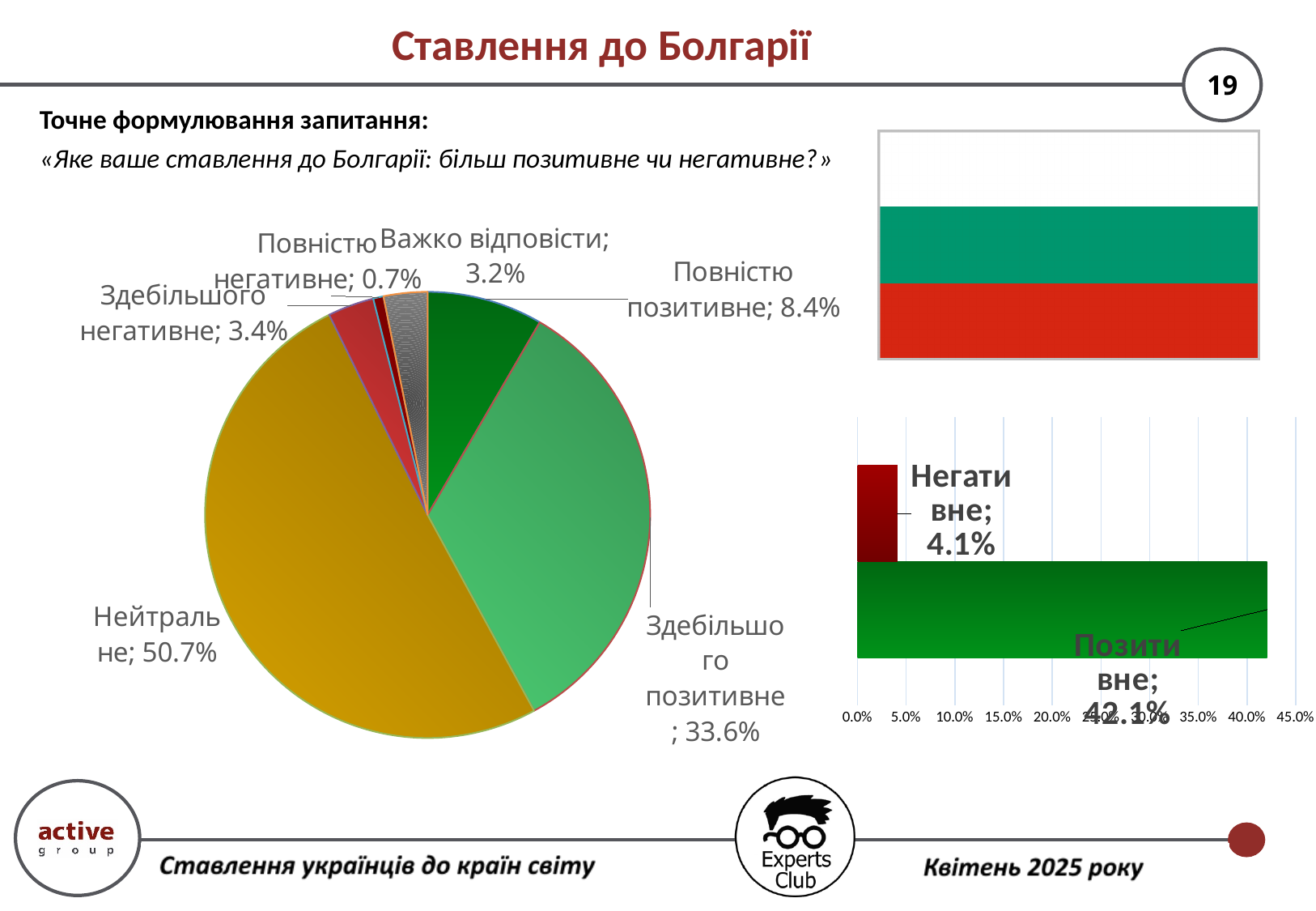
In the pie chart, how many slices (categories) are there? 6 In the bar chart on the right, what is the difference between «Позитивне» and «Негативне»? 38.0% In the pie chart, which category has the smallest share? Повністю негативне In the pie chart, what share is labelled for «Повністю позитивне»? 8.4% In the pie chart, what share is labelled for «Здебільшого позитивне»? 33.6% In the bar chart on the right, what is the value for «Позитивне»? 42.1% What type of chart is shown on the right side of the slide below the flag? Bar chart In the pie chart, which category has the largest share? Нейтральне In the bar chart on the right, what is the value for «Негативне»? 4.1% In the pie chart, what share is labelled for «Нейтральне»? 50.7% In the pie chart, what share is labelled for «Важко відповісти»? 3.2% In the pie chart, what is the difference between «Здебільшого негативне» and «Повністю негативне»? 2.7%